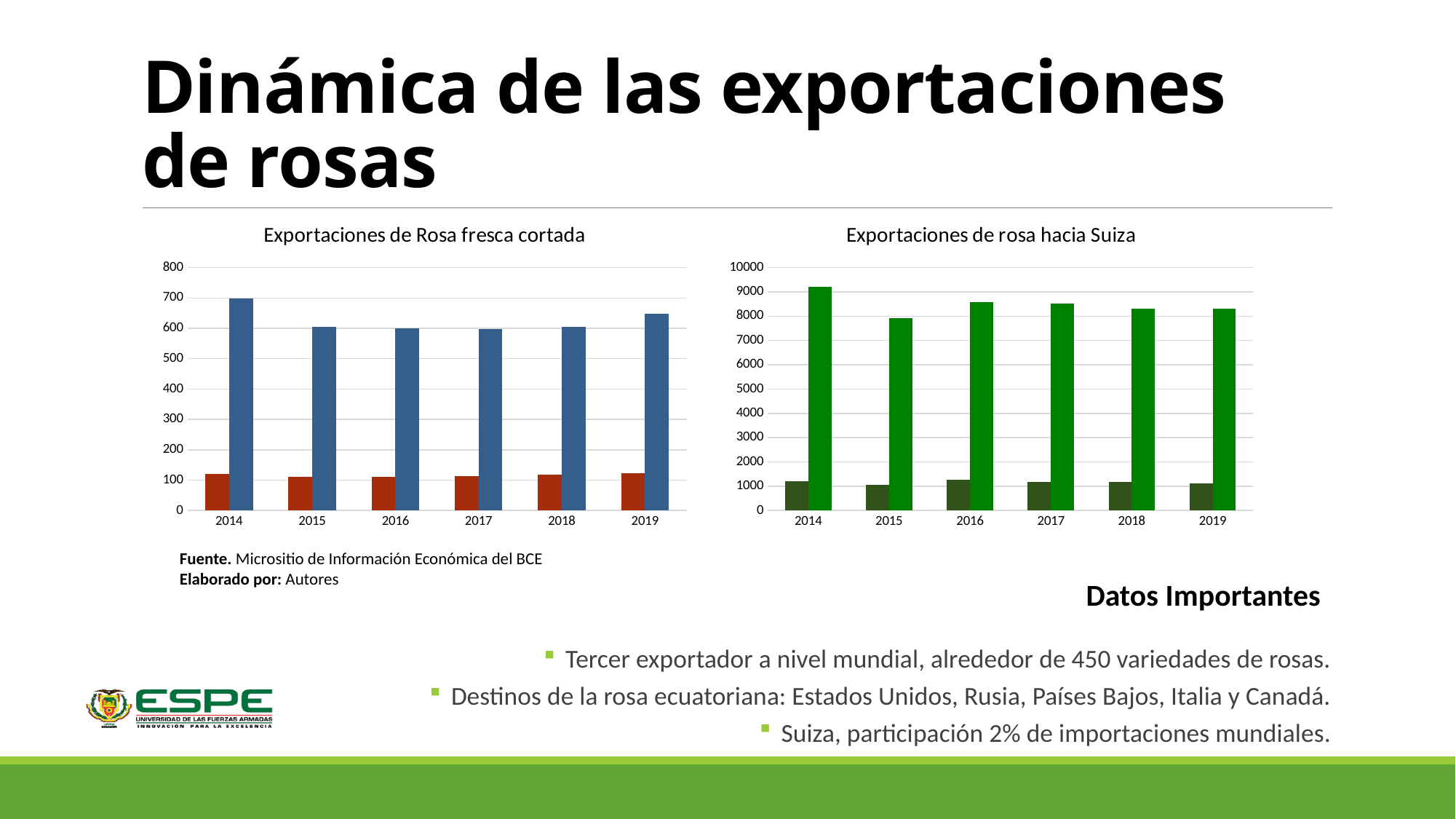
In the "Exportaciones de Rosa fresca cortada" chart, is the blue bar for 2014 greater or less than 600? greater In the "Exportaciones de rosa hacia Suiza" chart, is the bright green bar for 2015 greater or less than 8000? less In the "Exportaciones de rosa hacia Suiza" chart, is the bright green bar for 2016 or for 2015 taller? 2016 What kind of chart is "Exportaciones de Rosa fresca cortada"? bar chart In the "Exportaciones de rosa hacia Suiza" chart, which year has the shortest bright green bar? 2015 In the "Exportaciones de rosa hacia Suiza" chart, is the bright green bar for 2014 greater or less than 9000? greater How many years are shown on the x axis of the "Exportaciones de rosa hacia Suiza" chart? 6 In the "Exportaciones de Rosa fresca cortada" chart, which year has the tallest blue bar? 2014 In the "Exportaciones de Rosa fresca cortada" chart, is the blue bar for 2014 or for 2015 taller? 2014 In the "Exportaciones de rosa hacia Suiza" chart, which year has the tallest bright green bar? 2014 What is the title of the chart on the right side of the slide? Exportaciones de rosa hacia Suiza